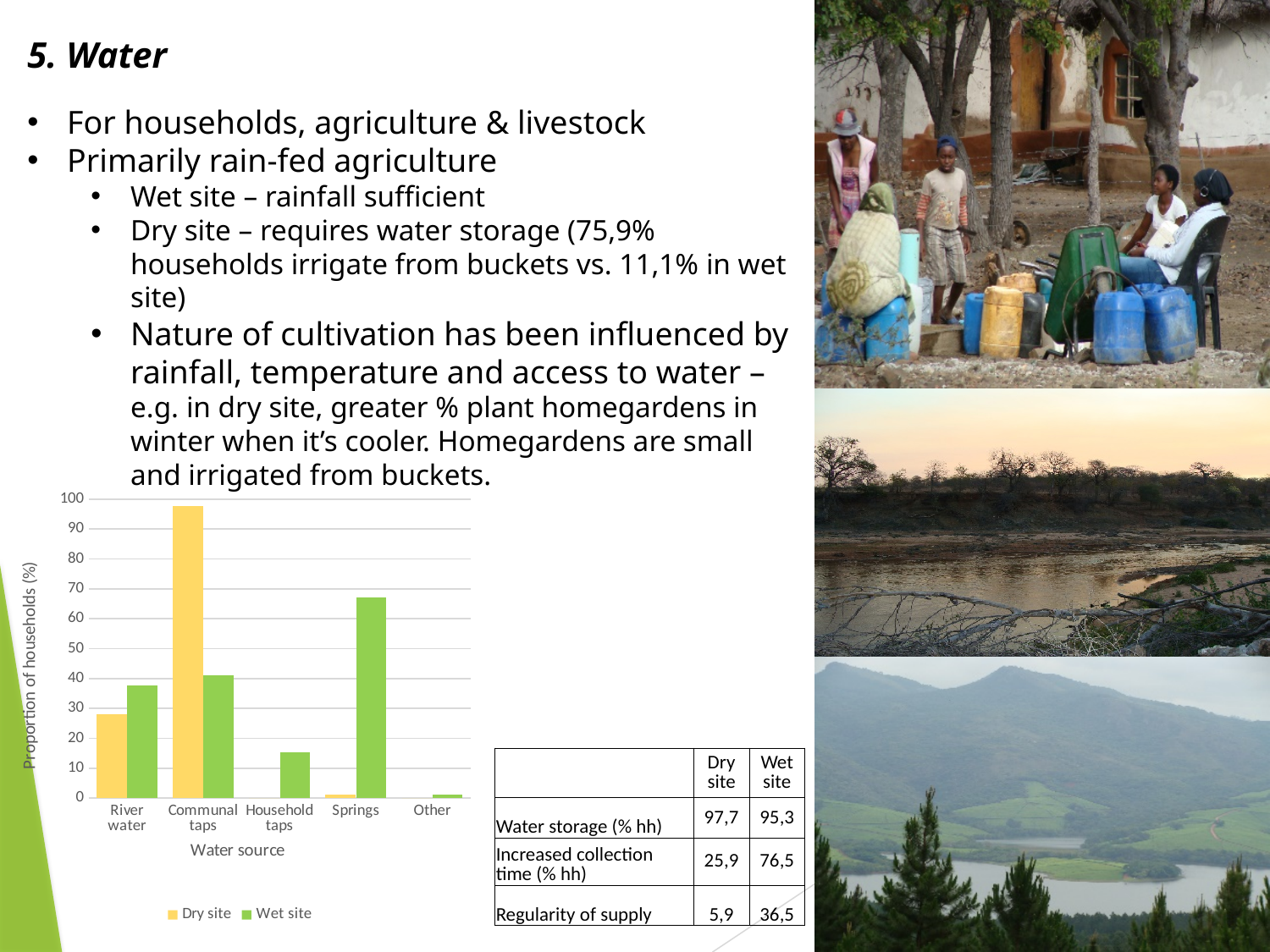
For Springs, which site has the larger proportion of households, Dry site or Wet site? Wet site Is the Dry site value for Communal taps greater or less than 90? greater How many water source categories are shown on the x axis of the chart? 5 Is the Wet site value for Household taps greater or less than 20? less For Communal taps, which site has the larger proportion of households, Dry site or Wet site? Dry site Which water source has the highest proportion of households for the Wet site? Springs How many series does the chart legend list? 2 Which colour represents the Wet site series in the chart? green Is the Wet site value for Springs greater or less than 60? greater What kind of chart is shown on the slide? bar chart What is the label of the y axis of the chart? Proportion of households (%) Which water source has the highest proportion of households for the Dry site? Communal taps